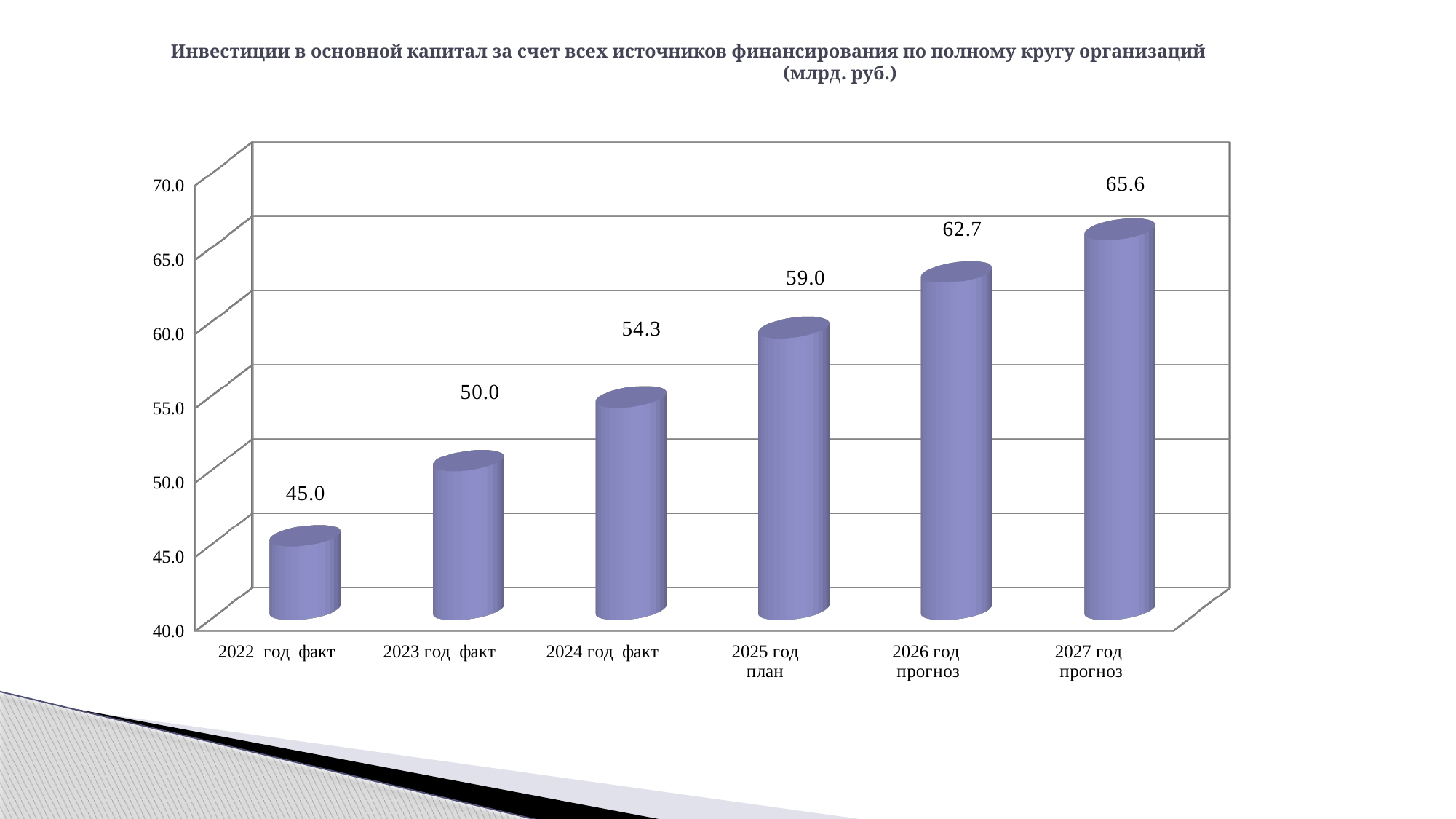
What is the value for 2027 год прогноз? 65.6 What is the value for 2022 год факт? 45.0 Which category has the highest value? 2027 год прогноз Is the value for 2024 год факт greater or less than 50.0? greater Do the values rise or fall from 2022 to 2027 along the x axis? rise What is the value for 2025 год план? 59.0 What kind of chart is shown on the slide? bar chart What is the difference between the values for 2027 год прогноз and 2022 год факт? 20.6 Which is larger, the value for 2026 год прогноз or the value for 2025 год план? 2026 год прогноз Which category has the lowest value? 2022 год факт What is the difference between the values for 2024 год факт and 2023 год факт? 4.3 How many categories are shown on the x axis? 6